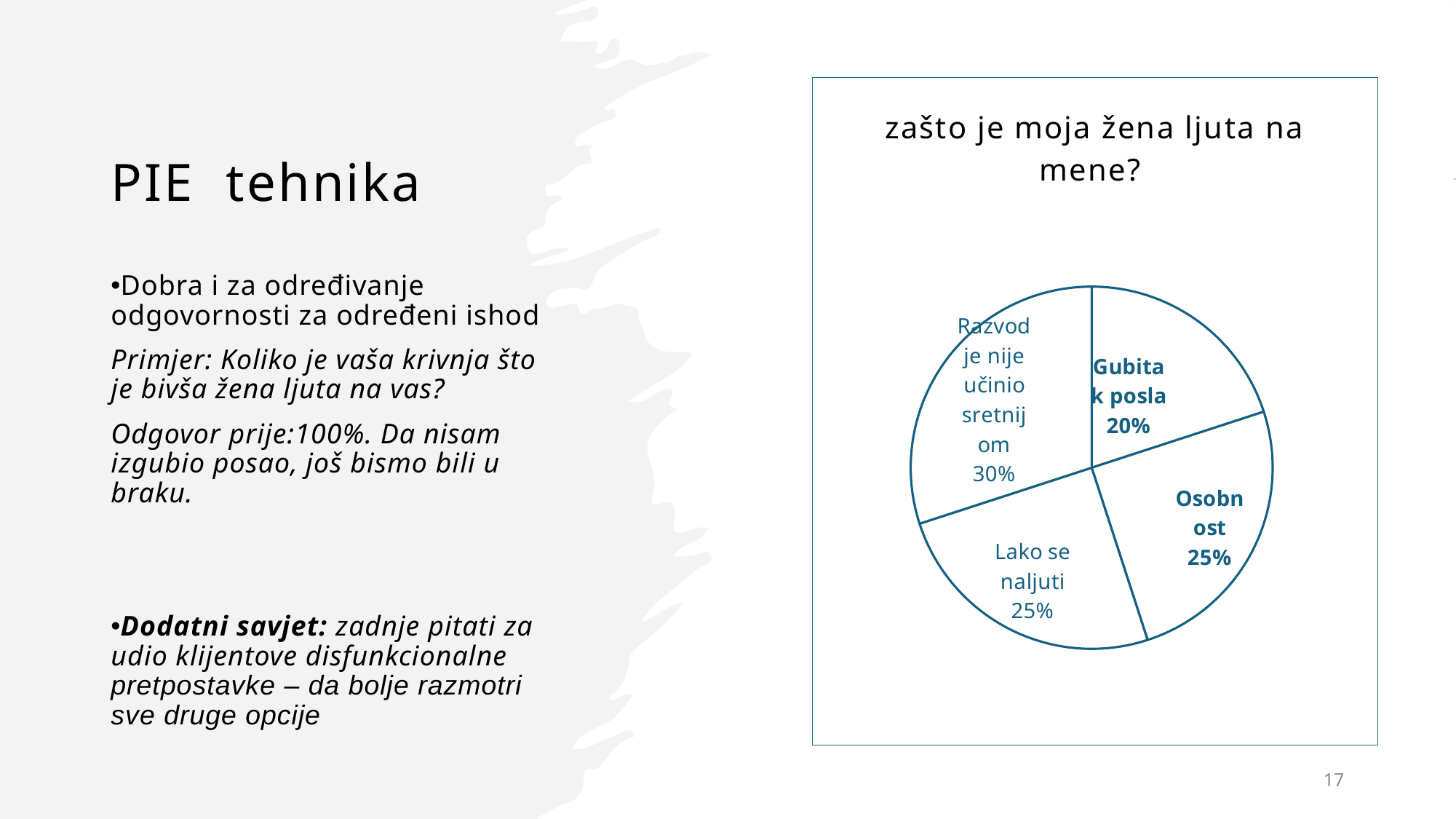
What is the title of the chart? zašto je moja žena ljuta na mene? What is the difference between the largest slice and the "Gubitak posla" slice? 10% What percentage of the pie chart is labelled "Gubitak posla"? 20% Which is larger, the "Gubitak posla" slice or the "Osobnost" slice? Osobnost What percentage is shown for the slice "Razvod je nije učinio sretnijom"? 30% What is the value shown for "Lako se naljuti"? 25% What type of chart is shown on the slide? Pie chart What share of the pie does "Osobnost" take? 25% Which slice of the pie chart is the largest? Razvod je nije učinio sretnijom How many slices does the pie chart have? 4 What is the combined share of "Osobnost" and "Lako se naljuti"? 50% Which slice of the pie chart is the smallest? Gubitak posla